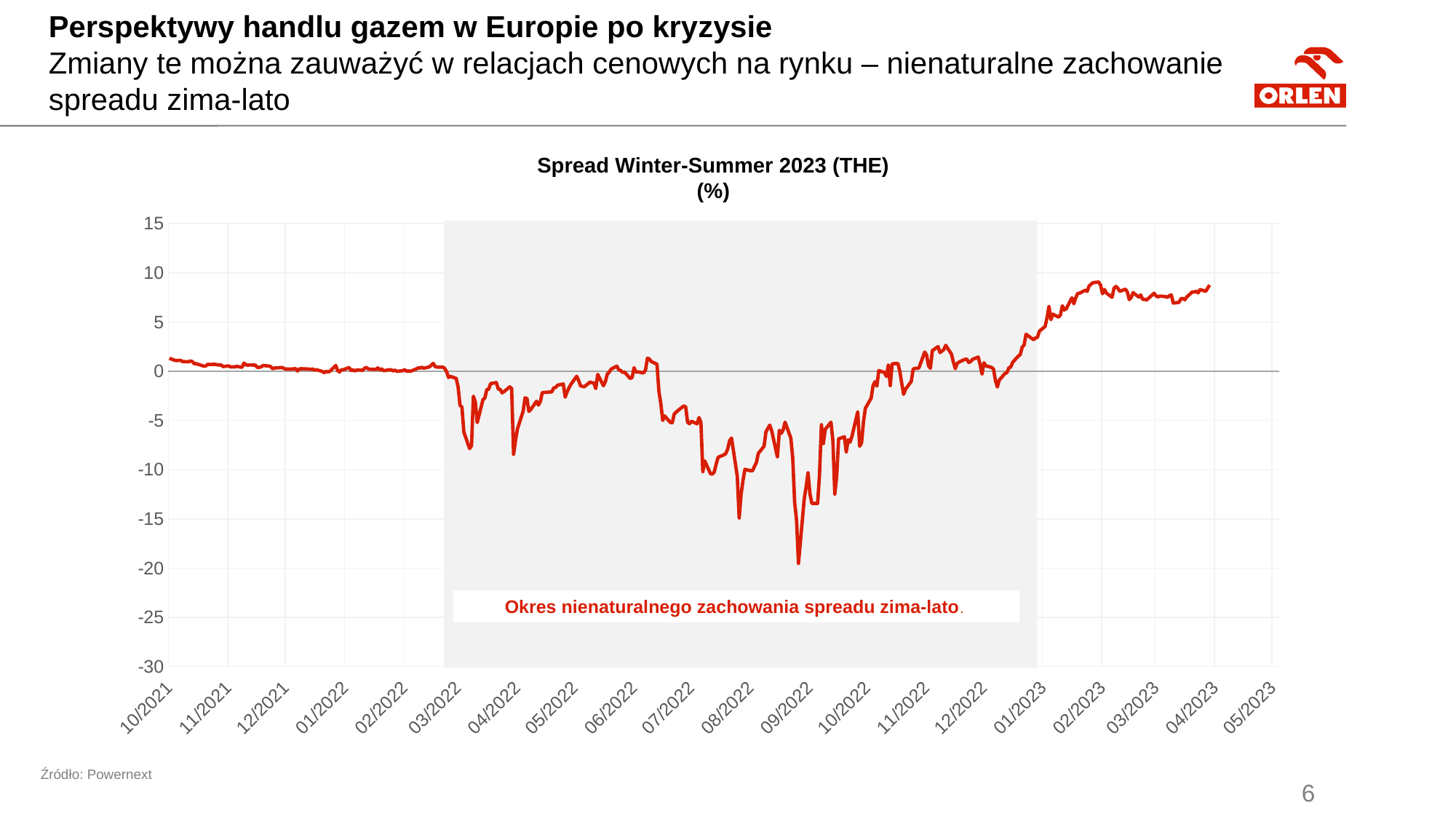
Does the line rise or fall between 09/2022 and 02/2023? rise Is the value of the spread at 02/2023 greater or less than 5? greater How many month labels are shown on the x axis? 20 What is the title of the chart? Spread Winter-Summer 2023 (THE) (%) Near which x-axis month label does the line reach its lowest point? 09/2022 Is the value of the spread at 10/2021 greater or less than 5? less What text is written in the shaded area of the chart? Okres nienaturalnego zachowania spreadu zima-lato. Does the line rise or fall between 06/2022 and 09/2022? fall Is the lowest value reached by the line greater or less than -15? less What type of chart is shown on the slide? line chart Which is larger, the spread value at 02/2023 or at 10/2021? 02/2023